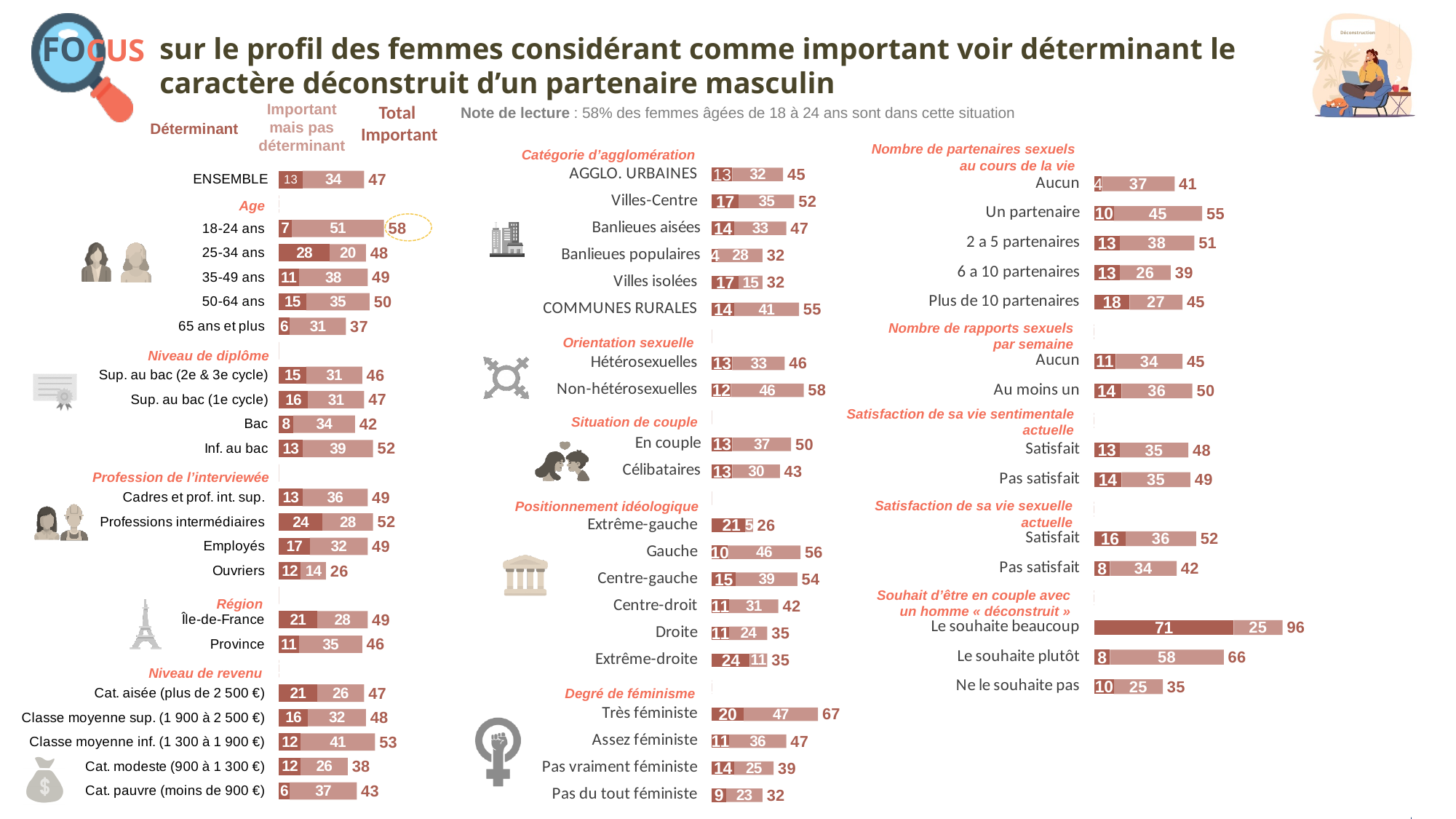
What type of chart is used on this slide? Stacked bar chart What is the Total Important value for ENSEMBLE? 47 In the 'Positionnement idéologique' chart, what is the 'Important mais pas déterminant' value for Extrême-gauche? 5 In the Age chart, what is the 'Déterminant' value for 25-34 ans? 28 In the 'Degré de féminisme' chart, how many categories are shown? 4 In the 'Degré de féminisme' chart, which category has the highest Total Important value? Très féministe In the 'Souhait d'être en couple avec un homme « déconstruit »' chart, what is the Total Important value for 'Le souhaite beaucoup'? 96 In the 'Souhait d'être en couple avec un homme « déconstruit »' chart, what is the difference in Total Important between 'Le souhaite beaucoup' and 'Ne le souhaite pas'? 61 In the 'Catégorie d'agglomération' chart, which category has the highest Total Important value? COMMUNES RURALES In the 'Positionnement idéologique' chart, which has a higher Total Important value, Gauche or Droite? Gauche In the Age chart, which age group has the lowest Total Important value? 65 ans et plus In the Age chart, what is the Total Important value for 18-24 ans? 58